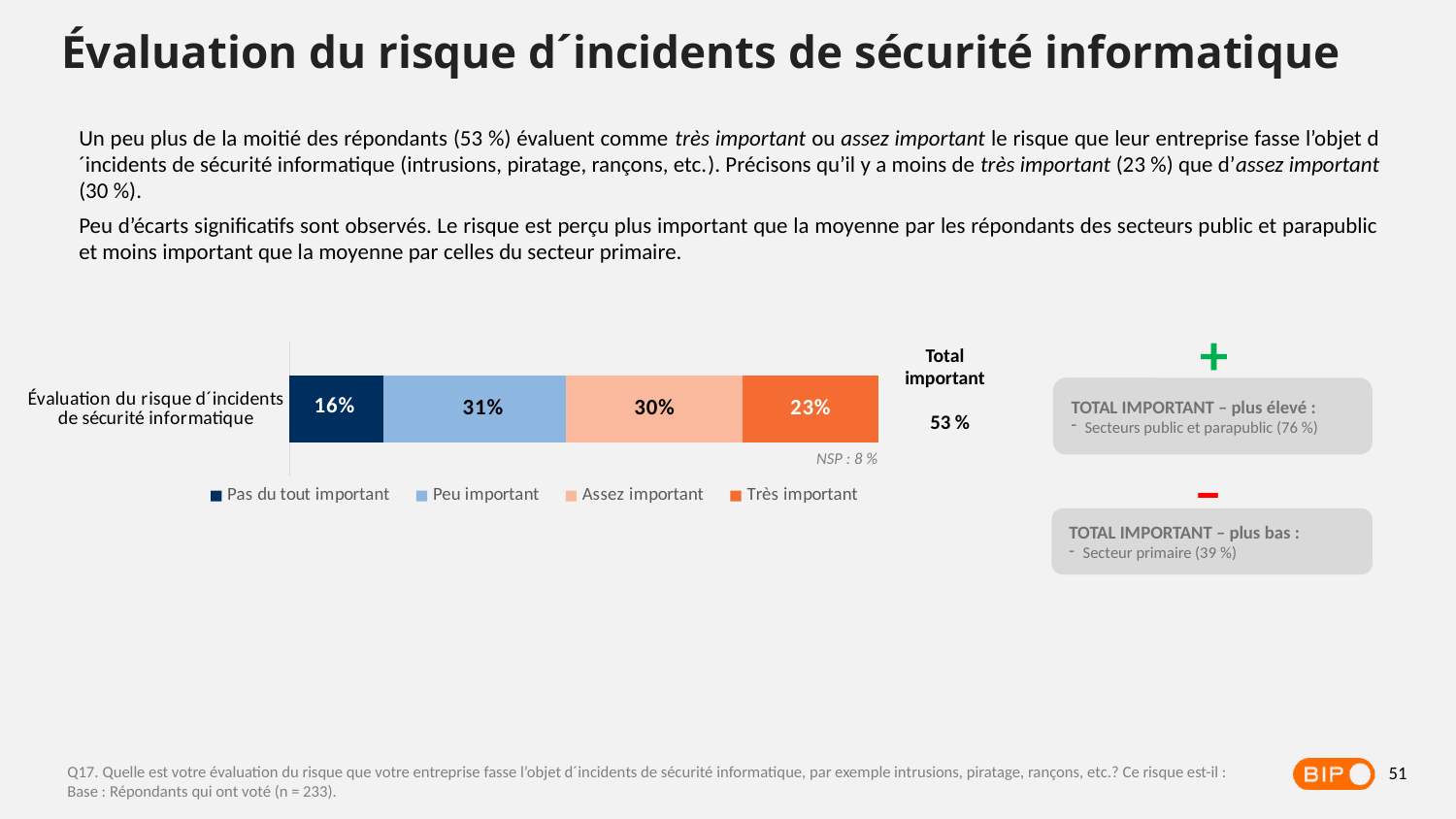
What percentage of respondents rated the risk as "Assez important"? 30% What is the difference in percentage points between "Assez important" and "Très important"? 7 What percentage of respondents rated the risk as "Pas du tout important"? 16% Which is larger, the share for "Peu important" or the share for "Pas du tout important"? Peu important Which response category has the lowest share in the bar? Pas du tout important What is the combined share of "Assez important" and "Très important" (Total important)? 53 % What colour represents "Très important" in the chart? Orange What percentage of respondents rated the risk as "Peu important"? 31% Which response category has the highest share in the bar? Peu important What percentage of respondents rated the risk as "Très important"? 23% What kind of chart is shown on the slide? Stacked bar chart How many series does the legend list? 4